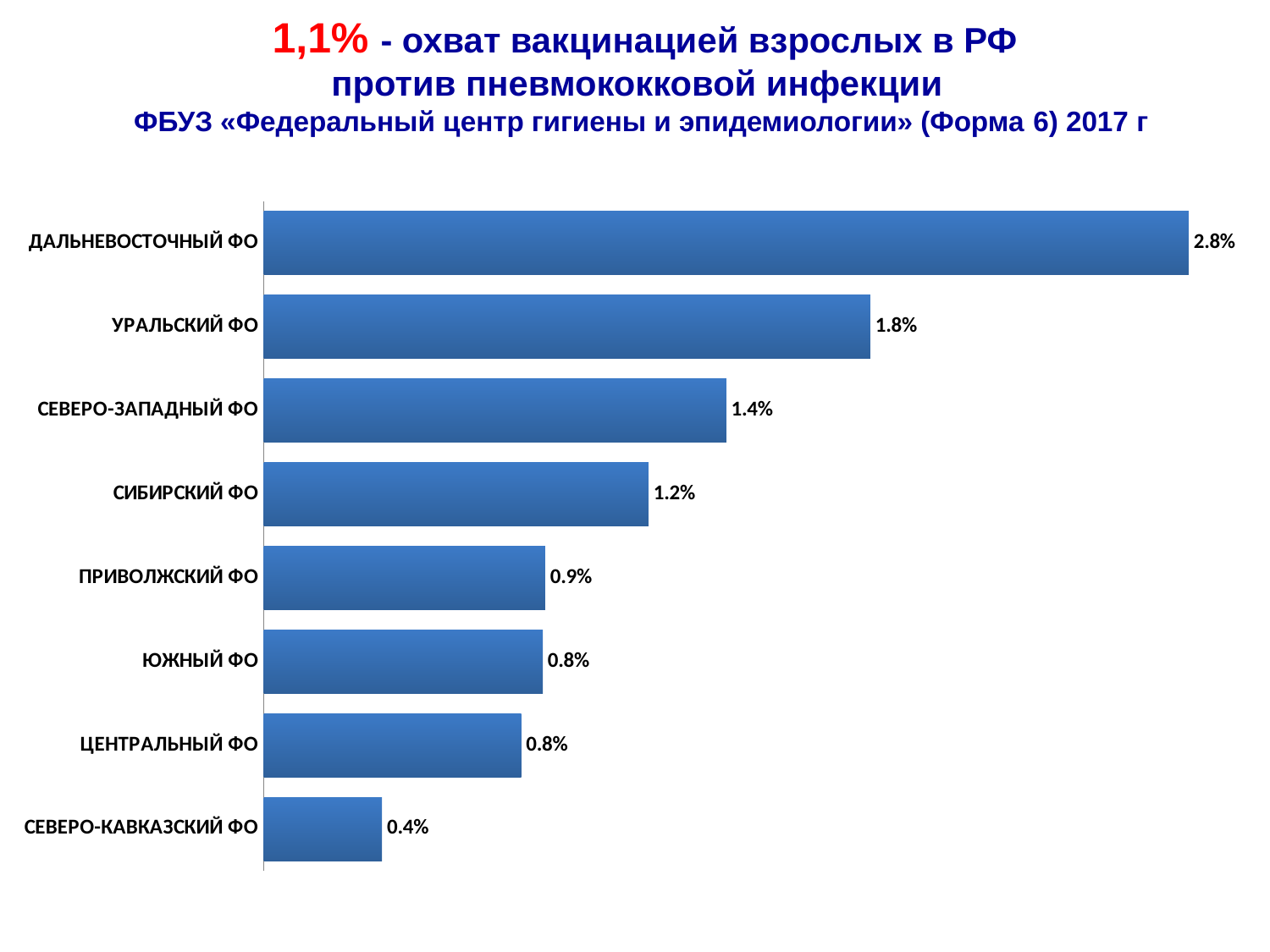
Which has a larger value, СИБИРСКИЙ ФО or ЮЖНЫЙ ФО? СИБИРСКИЙ ФО What is the difference between the values for ДАЛЬНЕВОСТОЧНЫЙ ФО and УРАЛЬСКИЙ ФО? 1.0% Which federal district has the lowest value on the chart? СЕВЕРО-КАВКАЗСКИЙ ФО What is the value shown for УРАЛЬСКИЙ ФО? 1.8% What is the vaccination coverage value for ДАЛЬНЕВОСТОЧНЫЙ ФО? 2.8% How many federal districts are shown on the chart? 8 What overall vaccination coverage figure for adults in the RF is highlighted in red in the slide title? 1,1% What is the value shown for СИБИРСКИЙ ФО? 1.2% What is the difference between the values for СЕВЕРО-ЗАПАДНЫЙ ФО and ПРИВОЛЖСКИЙ ФО? 0.5% What kind of chart is shown on the slide? Bar chart What is the value shown for СЕВЕРО-КАВКАЗСКИЙ ФО? 0.4% Which federal district has the highest value on the chart? ДАЛЬНЕВОСТОЧНЫЙ ФО